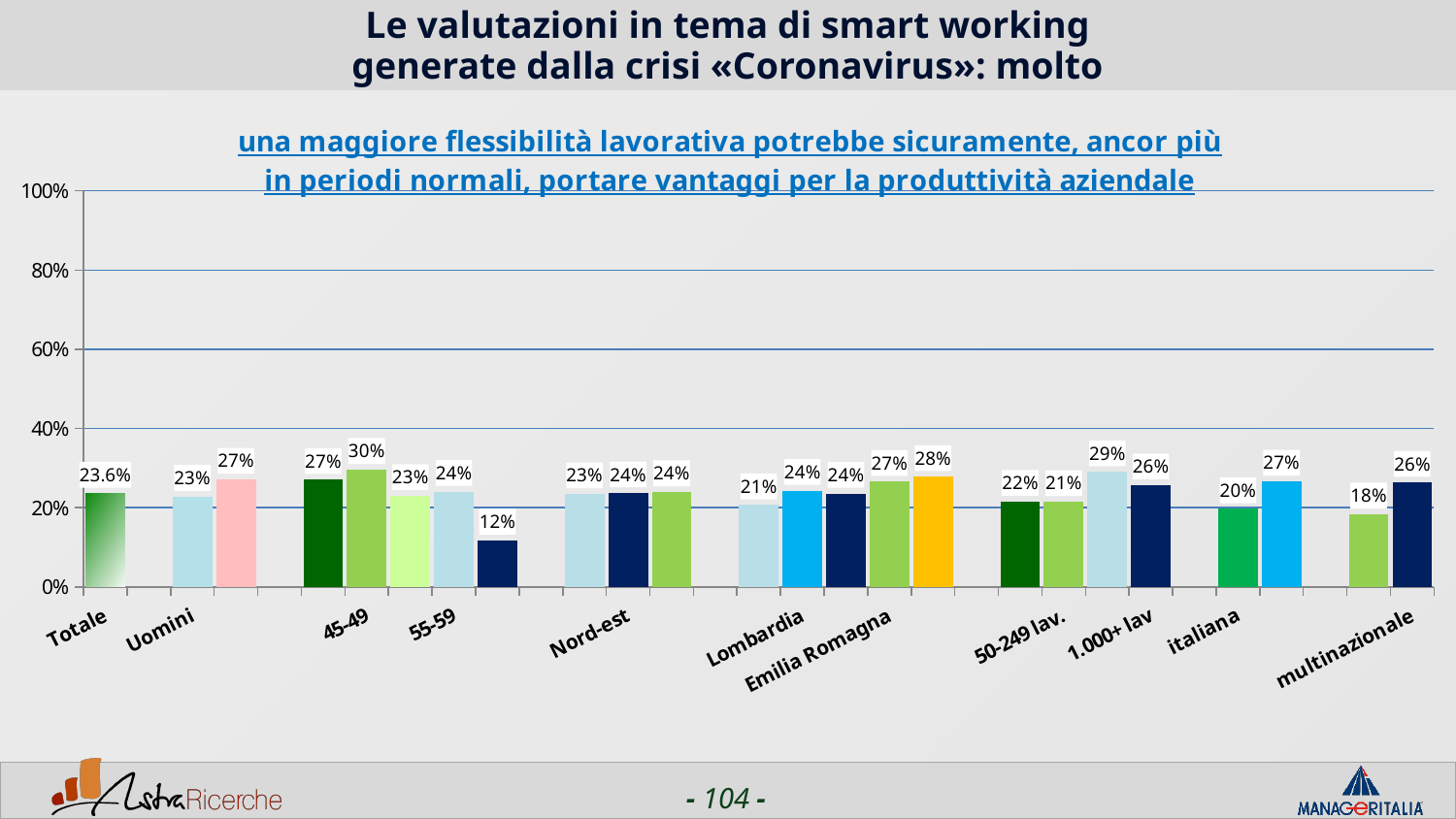
What is the value shown for Totale? 23.6% Is the value for Totale greater or less than 40%? less What is the highest value shown on the chart? 30% What is the difference between the values for 45-49 and 55-59? 6 percentage points What is the lowest value shown on the chart? 12% What kind of chart is shown on the slide? Bar chart What is the value shown for italiana? 20% Which has a higher value, Emilia Romagna or Lombardia? Emilia Romagna What is the value shown for Emilia Romagna? 27% What is the value shown for the 45-49 age group? 30% What is the value shown for 1.000+ lav? 26% What is the value shown for Uomini? 23%